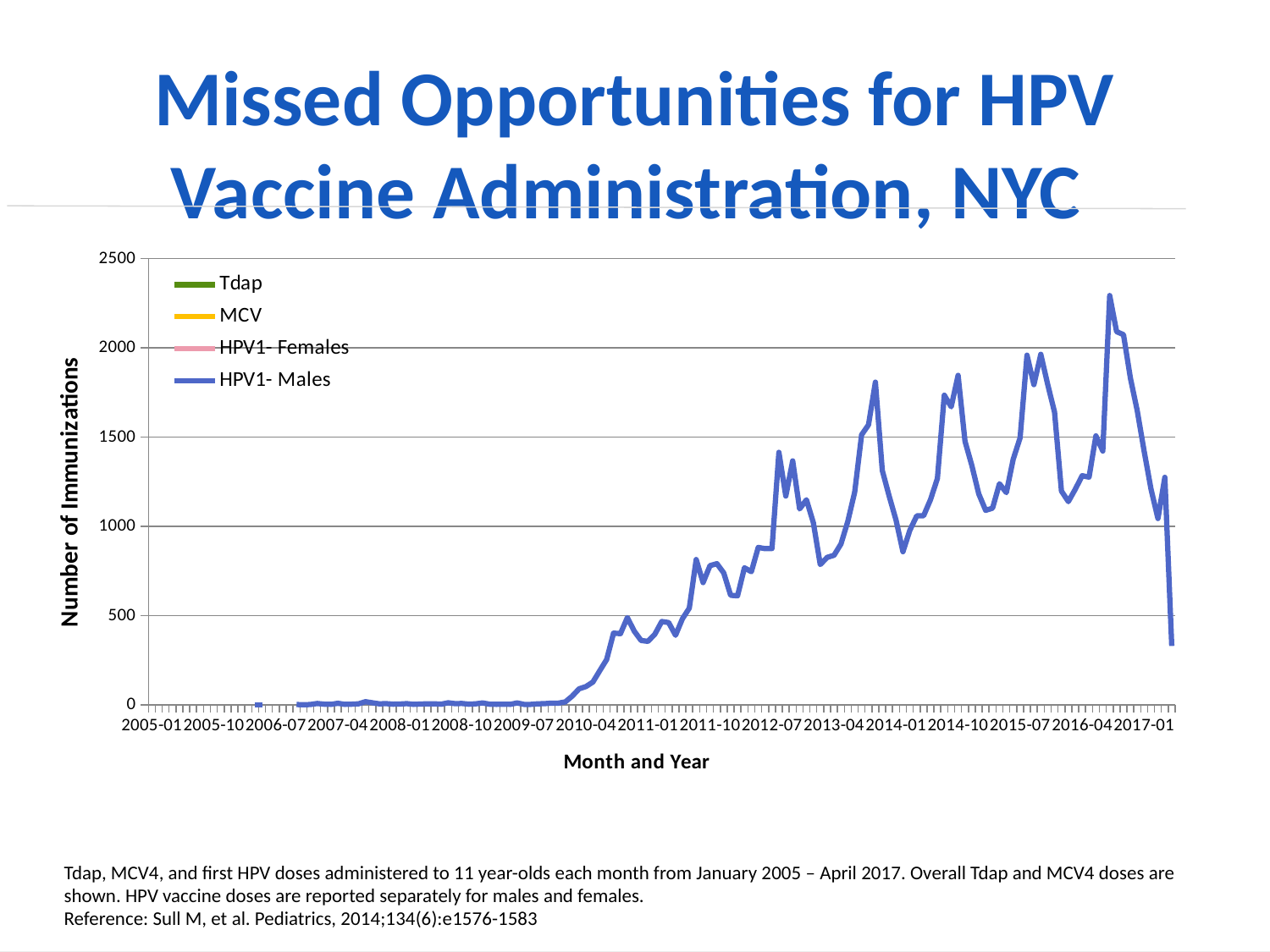
Does the HPV1- Males series generally rise or fall from 2005-01 to 2016-04? rise Is the peak value for HPV1- Males around 2016-04 to 2017-01 greater or less than 2000? greater Is the value for HPV1- Males at 2008-01 greater or less than 500? less Is the value for HPV1- Males at 2014-01 greater or less than 1500? less What is the title of the chart's vertical axis? Number of Immunizations How many series does the legend list? 4 Which series reaches the highest values on the chart? HPV1- Males What kind of chart is shown on the slide? line chart What is the title of the chart's horizontal axis? Month and Year